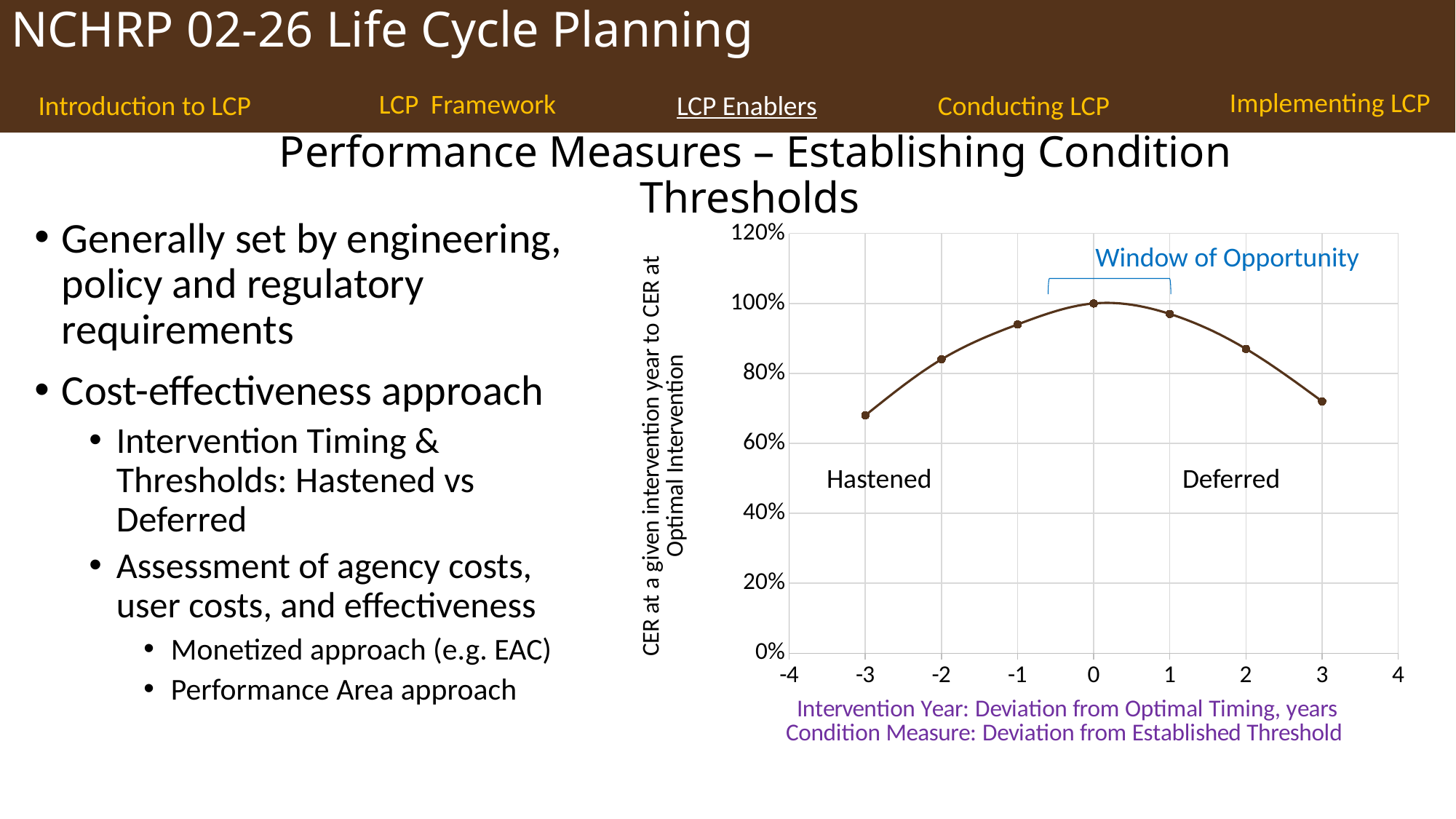
At which intervention year deviation is the CER value highest? 0 How do the values change as the intervention year goes from -3 to 0? they rise What kind of chart is shown on the slide? line chart Which has the larger CER value: intervention year -3 or intervention year 3? 3 Is the value at intervention year -3 greater or less than 80%? less How many data points are plotted on the curve? 7 What is the value of CER at intervention year 0 (optimal timing)? 100% Is the value at intervention year 1 greater or less than 100%? less Is the value at intervention year -2 greater or less than 80%? greater What label is shown in blue above the bracket near the peak of the curve? Window of Opportunity At which intervention year deviation is the CER value lowest? -3